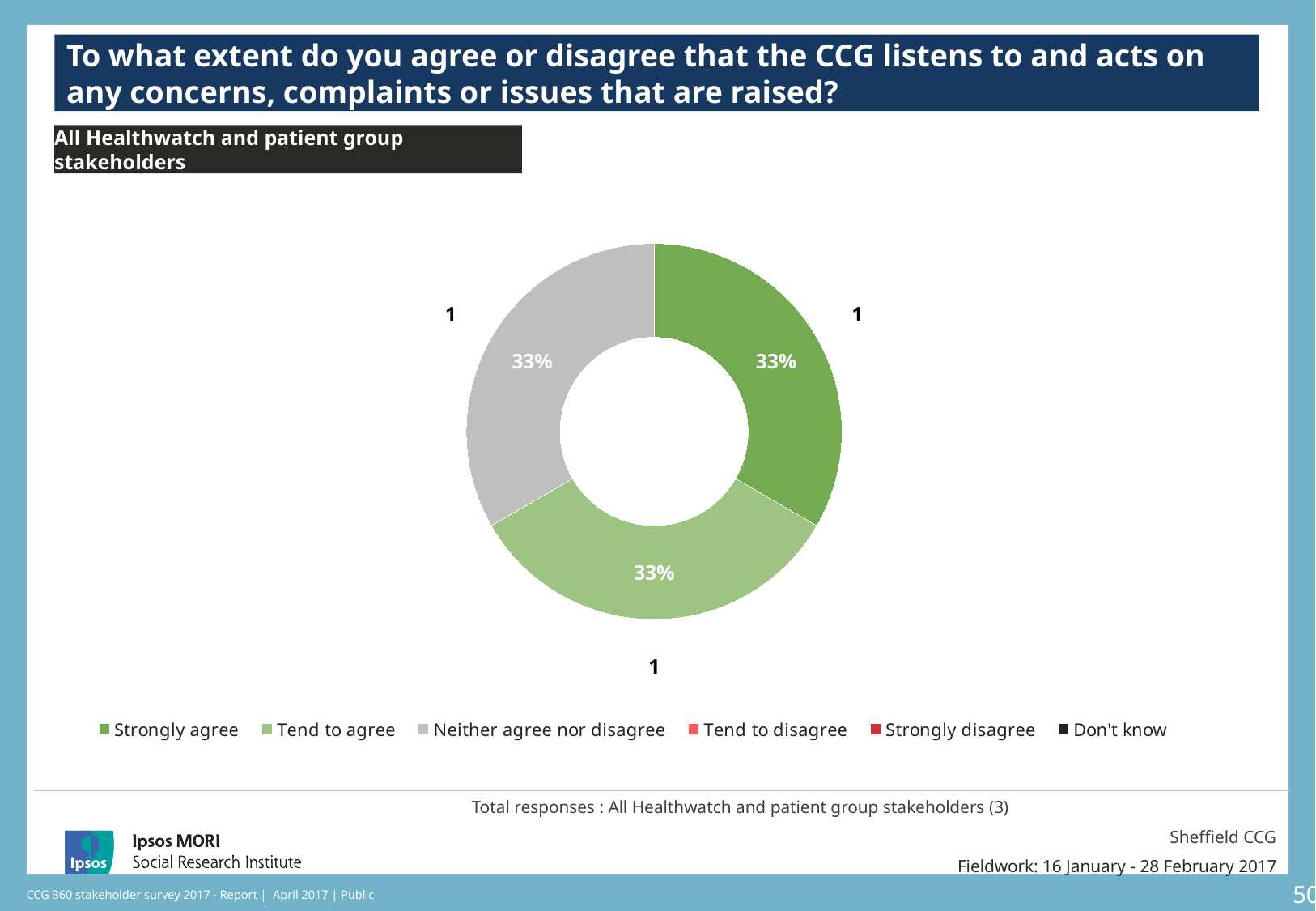
What percentage of respondents said they tend to agree? 33% How many respondents are in the 'Neither agree nor disagree' slice, according to the count label next to it? 1 What percentage of respondents said they strongly agree? 33% What is the difference between the 'Strongly agree' share and the 'Tend to agree' share? 0% How many respondents are in the 'Strongly agree' slice, according to the count label next to it? 1 What colour is used for the 'Neither agree nor disagree' slice? Grey How many response categories does the legend list? 6 Which stakeholder group does the chart cover? All Healthwatch and patient group stakeholders What percentage of respondents said they neither agree nor disagree? 33% What kind of chart is shown on the slide? Donut (pie) chart What is the total number of responses stated below the chart? 3 How many slices are visible in the chart? 3